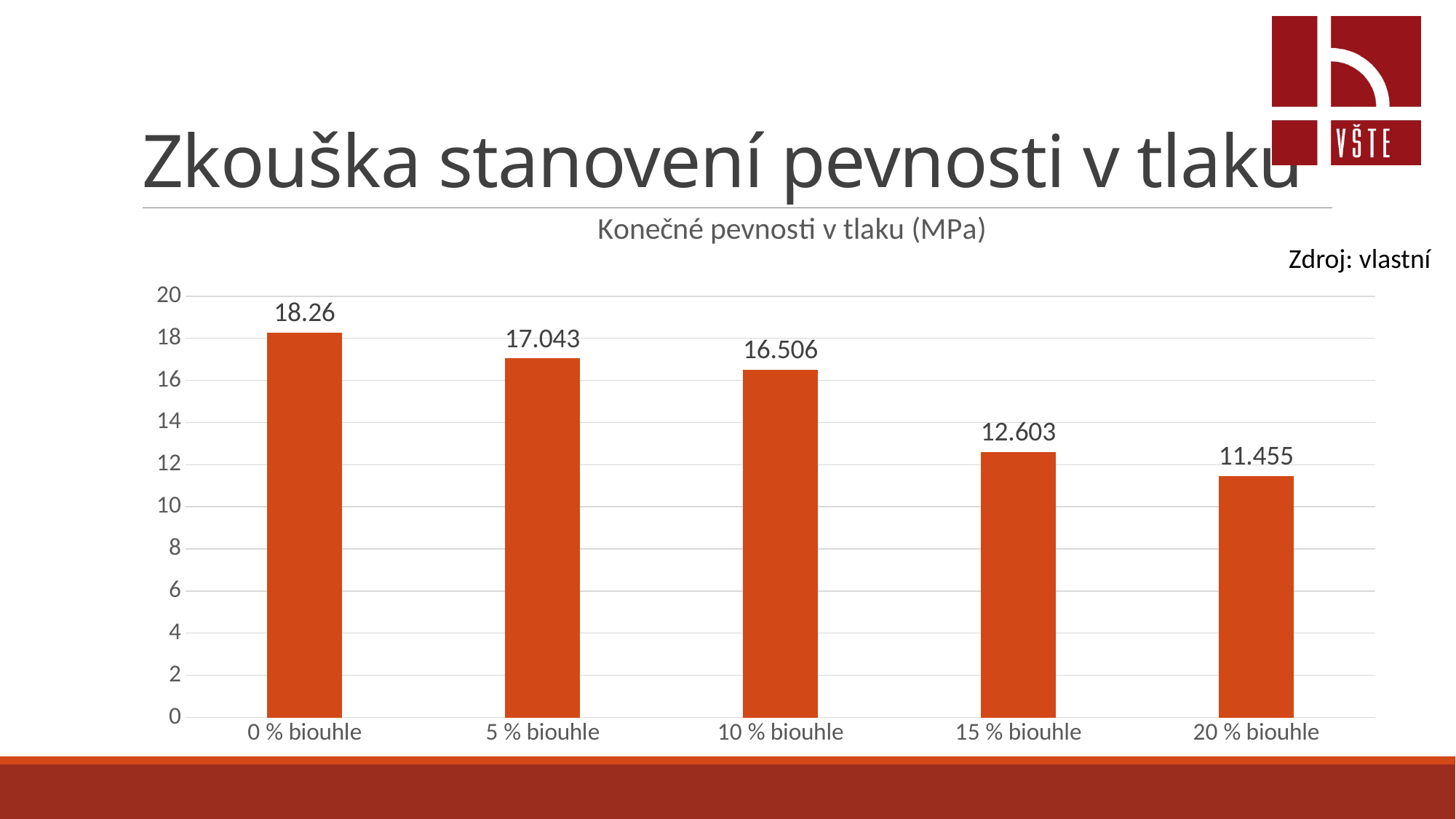
What is the value for 20 % biouhle? 11.455 Which category has the lowest value? 20 % biouhle Which category has the highest value? 0 % biouhle Is the value for 15 % biouhle greater or less than 14? less What is the value for 15 % biouhle? 12.603 What is the difference between the values for 0 % biouhle and 20 % biouhle? 6.805 What is the difference between the values for 5 % biouhle and 10 % biouhle? 0.537 Do the values rise or fall from left to right along the x axis? fall How many categories are shown on the x axis? 5 What kind of chart is shown on the slide? bar chart What is the value for 0 % biouhle? 18.26 Which is larger, the value for 10 % biouhle or the value for 15 % biouhle? 10 % biouhle